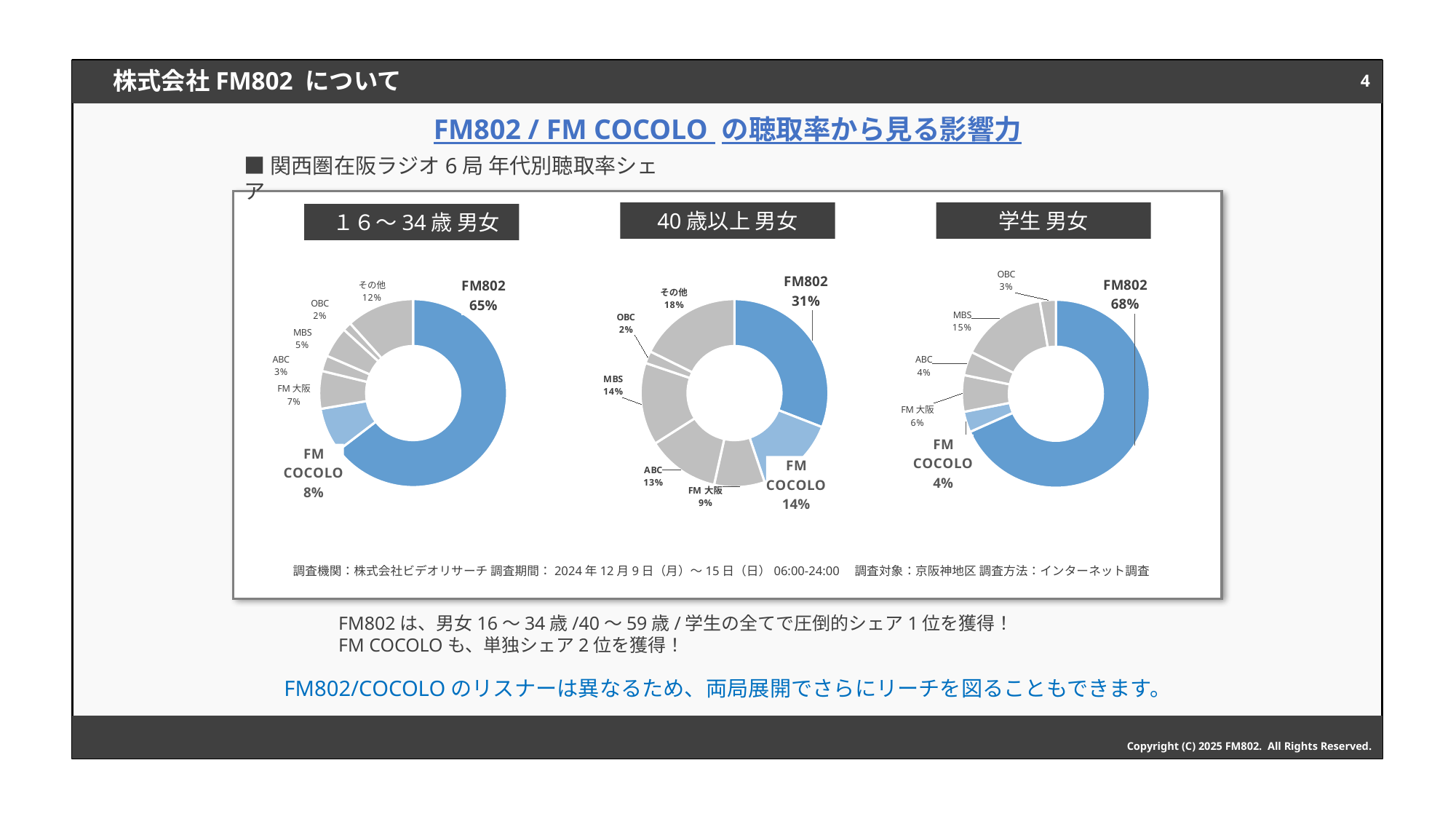
In the 40歳以上 男女 chart, what share does FM COCOLO have? 14% In the 40歳以上 男女 chart, which is larger, the ABC share or the FM大阪 share? ABC In the 16～34歳 男女 chart, which station has the smallest share? OBC In the 40歳以上 男女 chart, what share does その他 have? 18% How many donut charts are shown on the slide? 3 What type of chart is used for the 16～34歳 男女 data? Donut (pie) chart In the 16～34歳 男女 chart, what share does FM802 have? 65% In the 学生 男女 chart, which station has the largest share? FM802 In the 学生 男女 chart, what share does MBS have? 15% How many slices does the 学生 男女 chart have? 6 In the 40歳以上 男女 chart, what is the difference between the FM802 share and the FM COCOLO share? 17% In the 学生 男女 chart, what is the difference between the FM802 share and the MBS share? 53%